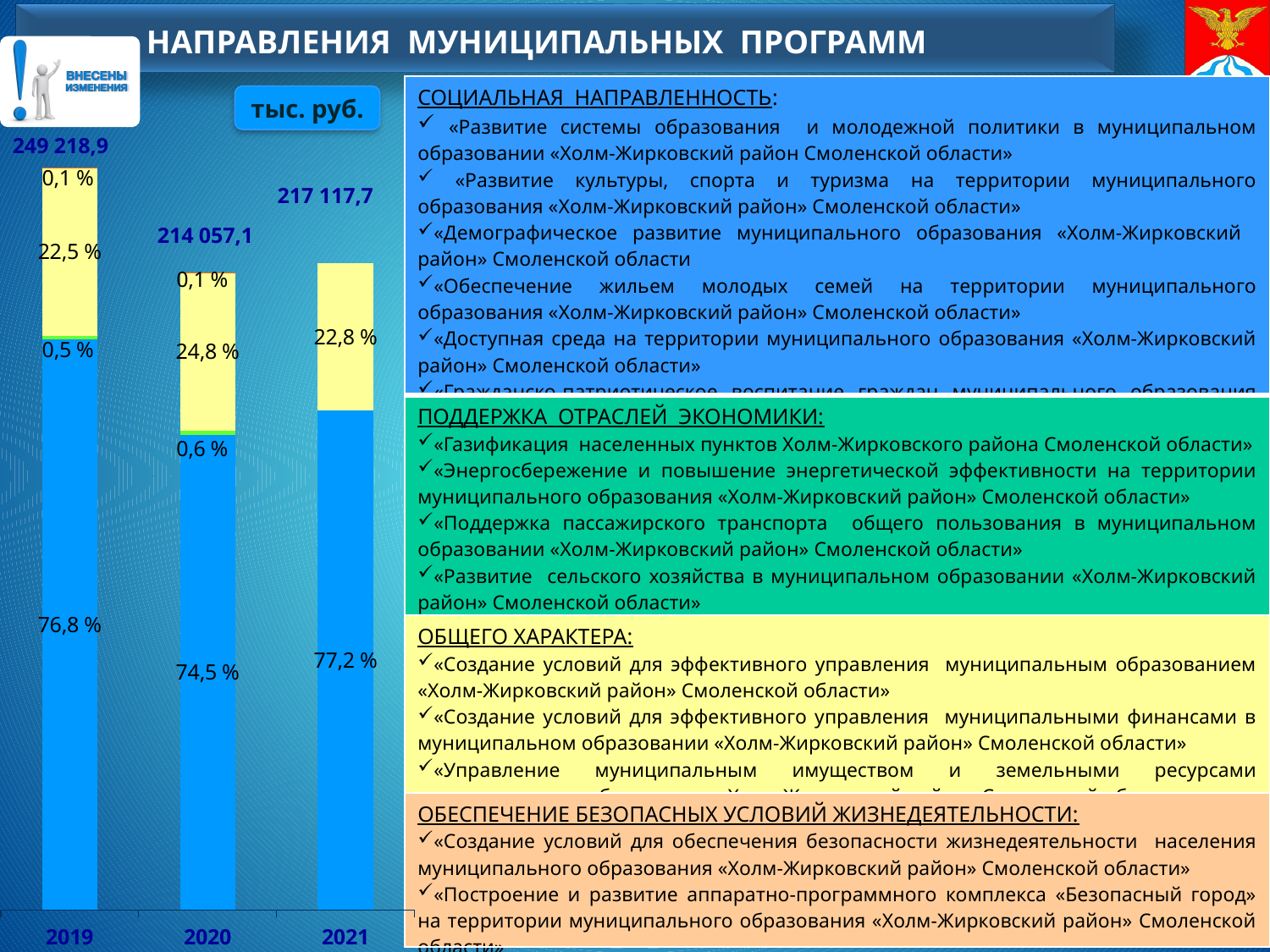
Which year has the larger blue (bottom) segment percentage, 2019 or 2020? 2019 How many bars (years) are shown in the chart? 3 What is the total value shown above the bar for 2021? 217 117,7 What percentage is labelled on the green segment of the 2020 bar? 0,6 % Which year has the lowest total value? 2020 What percentage is labelled on the blue (bottom) segment of the 2021 bar? 77,2 % Which year has the highest total value? 2019 What is the difference between the total values for 2019 and 2020? 35 161,8 What is the total value shown above the bar for 2019? 249 218,9 What percentage is labelled on the yellow segment of the 2020 bar? 24,8 % What kind of chart is shown on the slide? Stacked bar chart What is the total value shown above the bar for 2020? 214 057,1